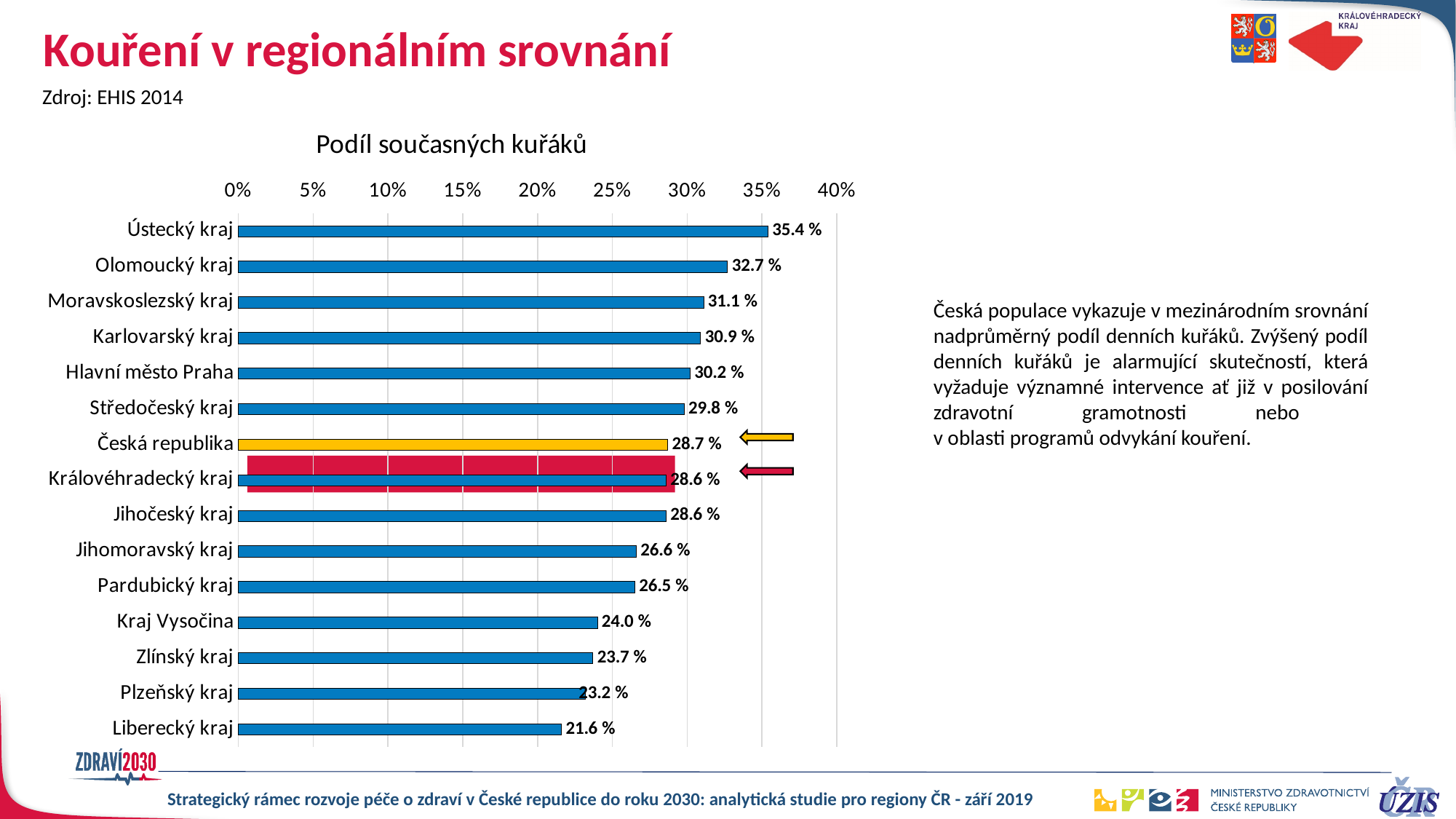
What is the difference between the values for Ústecký kraj and Liberecký kraj? 13.8 percentage points What is the value for Liberecký kraj? 21.6 % What is the value for Česká republika? 28.7 % What kind of chart is shown on the slide? bar chart Which region has the lowest share of current smokers? Liberecký kraj Is the value for Kraj Vysočina greater or less than 25%? less Which has a larger value, Olomoucký kraj or Moravskoslezský kraj? Olomoucký kraj What is the title of the chart? Podíl současných kuřáků How many categories are shown in the chart? 15 Which region has the highest share of current smokers? Ústecký kraj What is the value for Královéhradecký kraj? 28.6 % What is the value for Ústecký kraj? 35.4 %